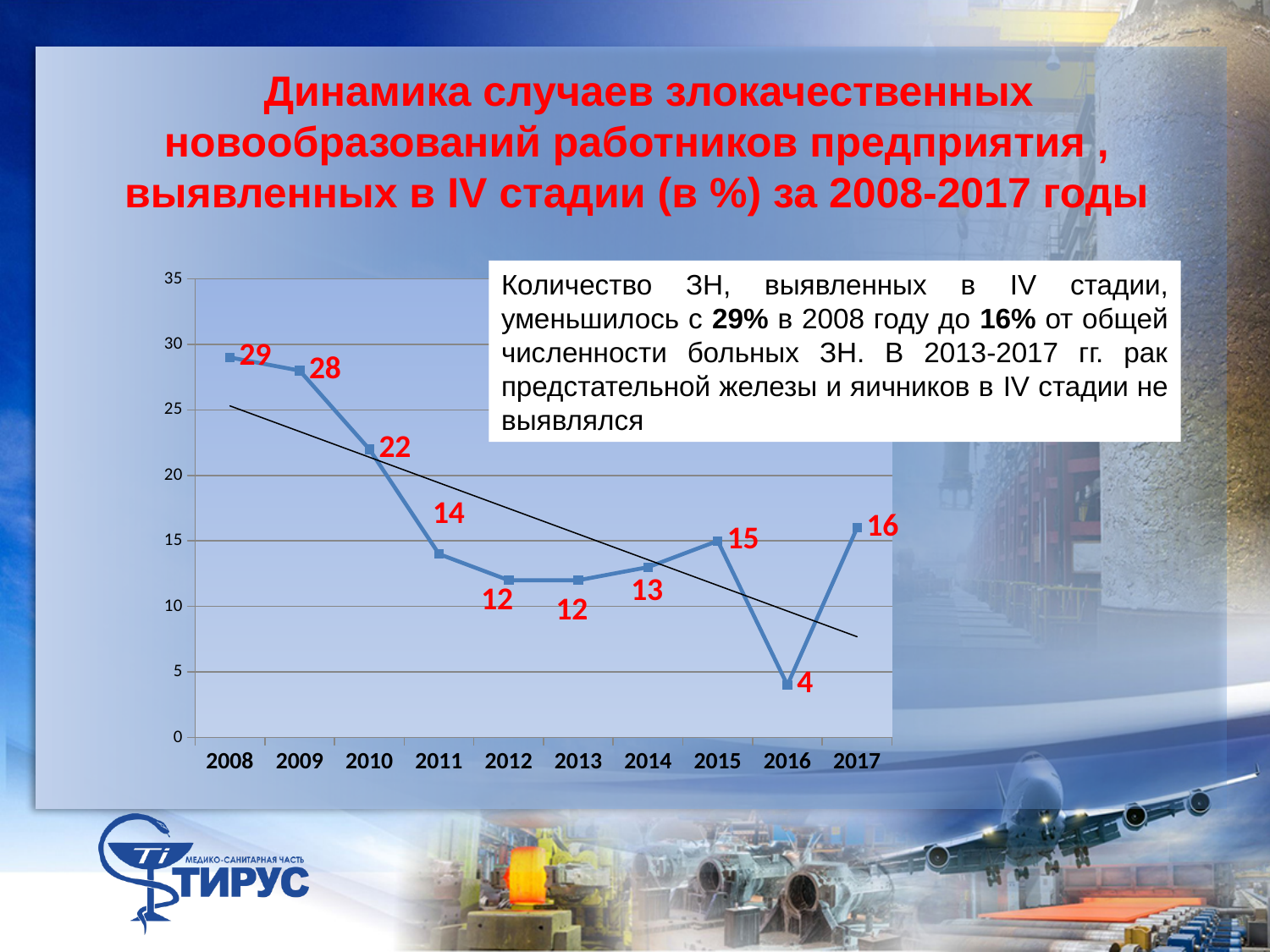
What is the value for 2008? 29 Is the value for 2014 greater or less than 15? less What type of chart is shown on the slide? line chart Which is larger, the value for 2010 or the value for 2015? 2010 What is the value for 2017? 16 What is the difference between the values for 2008 and 2017? 13 What is the value for 2011? 14 Does the value rise or fall from 2008 to 2011? fall Which year has the lowest value? 2016 Which year has the highest value? 2008 How many years are plotted on the x axis? 10 What is the value for 2016? 4